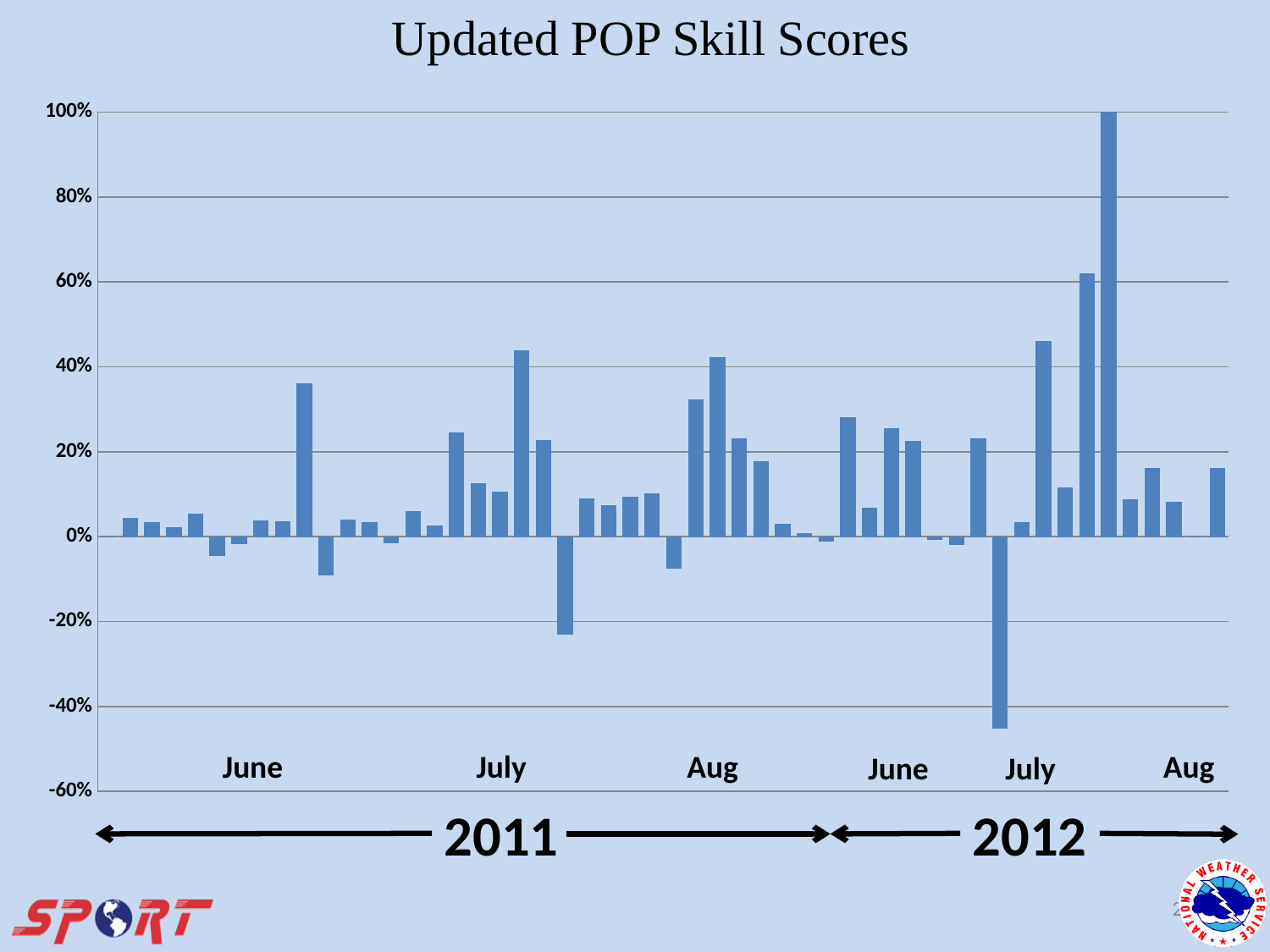
What is the highest value shown on the vertical axis? 100% Which year has the taller maximum bar, 2011 or 2012? 2012 Is the value of the tallest bar on the chart greater or less than 80%? greater Is the value of the lowest bar on the chart greater or less than -40%? less Is the value of the tallest bar in 2011 greater or less than 60%? less Which months are labelled along the x axis for each year? June, July, Aug In which year does the tallest bar on the chart occur? 2012 What kind of chart is shown on the slide? bar chart In which year does the lowest (most negative) bar on the chart occur? 2012 What is the title of the chart? Updated POP Skill Scores How many year periods are marked along the bottom of the chart? 2